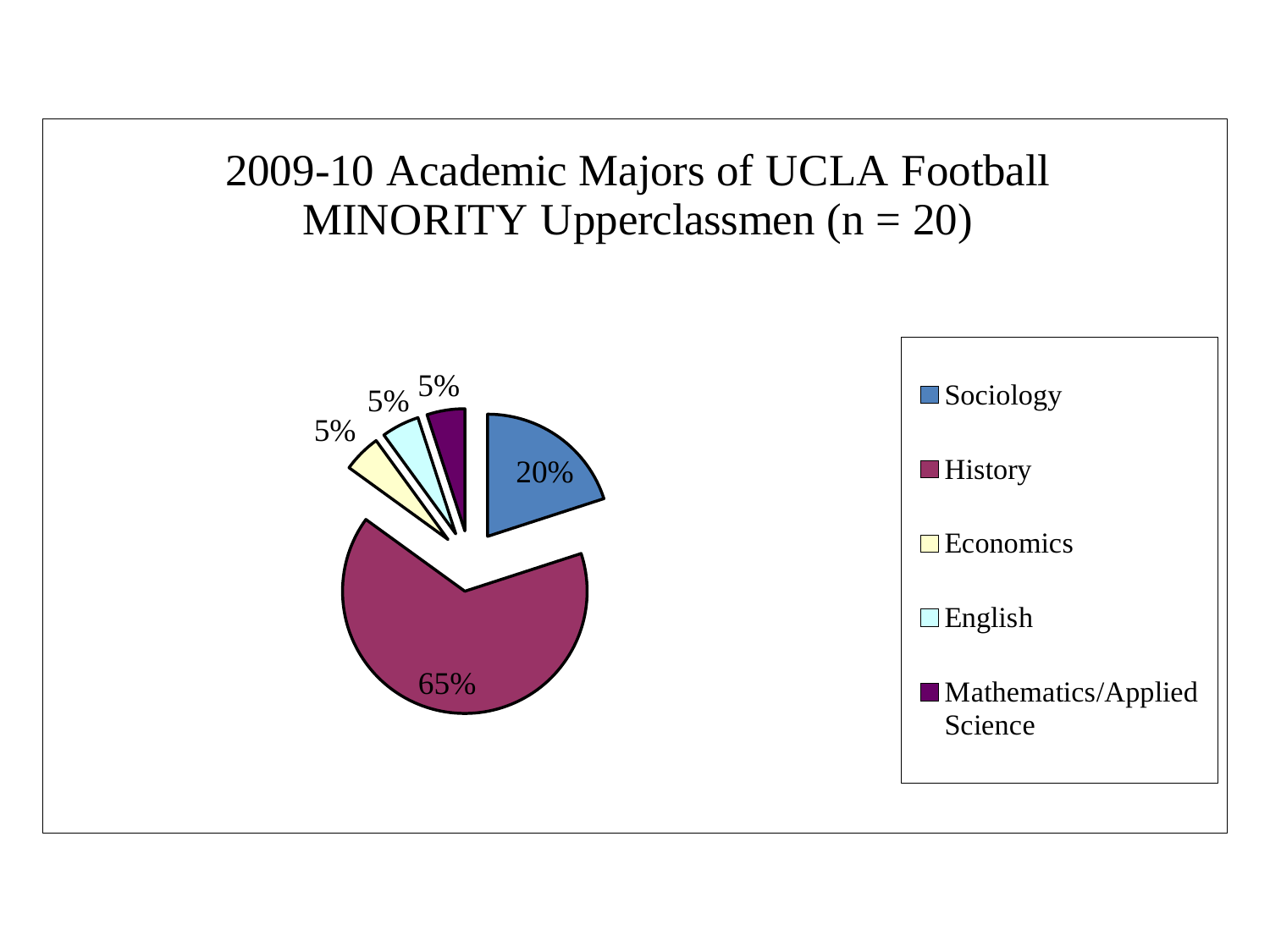
How many majors are listed in the legend? 5 Which is larger, the slice for Sociology or the slice for English? Sociology Which major has the largest slice of the pie? History How many slices does the pie chart have? 5 What kind of chart is shown on the slide? Pie chart What share of the pie does History represent? 65% What share of the pie does Sociology represent? 20% What share of the pie does Economics represent? 5% What colour is the slice for History? Maroon What is the difference in percentage points between the History slice and the Sociology slice? 45 What is the title of the chart? 2009-10 Academic Majors of UCLA Football MINORITY Upperclassmen (n = 20)